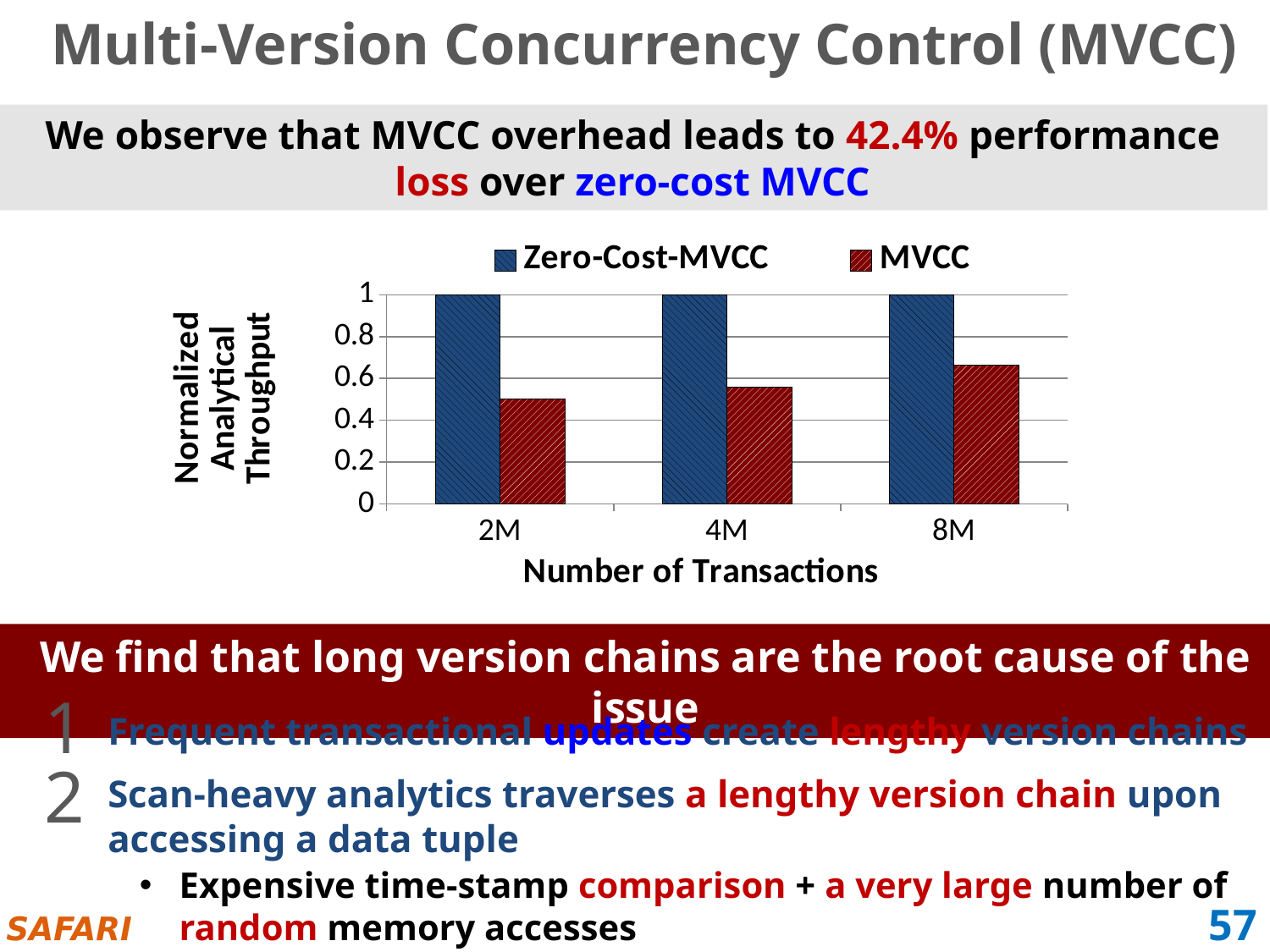
What is the normalized analytical throughput for Zero-Cost-MVCC at 2M transactions? 1 Is the MVCC value at 4M transactions greater or less than 0.6? less Is the MVCC value at 8M transactions greater or less than 0.6? greater Which series has the larger value at 4M transactions, Zero-Cost-MVCC or MVCC? Zero-Cost-MVCC What is the normalized analytical throughput for Zero-Cost-MVCC at 8M transactions? 1 How many categories are shown on the x axis of the chart? 3 Do the MVCC values rise or fall as the number of transactions increases from 2M to 8M? rise At which number of transactions is the MVCC throughput lowest? 2M At which number of transactions is the MVCC throughput highest? 8M What kind of chart is shown on the slide? bar chart Is the MVCC value at 2M transactions greater or less than 0.6? less How many series does the chart legend list? 2